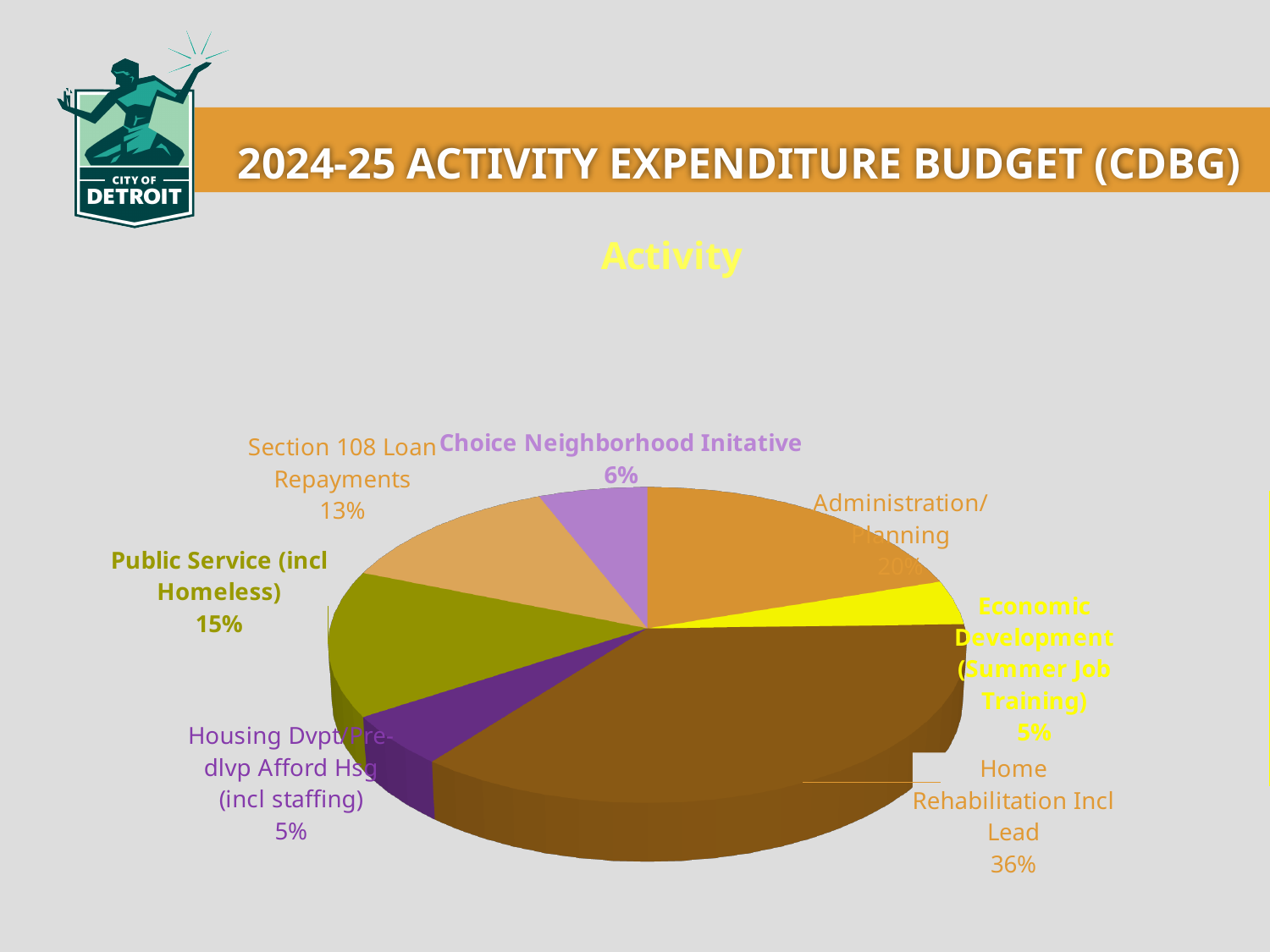
How many slices does the pie chart have? 7 What share of the budget goes to Choice Neighborhood Initiative? 6% What kind of chart is shown on the slide? pie chart Which activity has the largest share of the budget? Home Rehabilitation Incl Lead What is the difference in percentage points between Section 108 Loan Repayments and Choice Neighborhood Initiative? 7 Which is larger, the share for Public Service (incl Homeless) or the share for Section 108 Loan Repayments? Public Service (incl Homeless) What share of the budget goes to Economic Development (Summer Job Training)? 5% What share of the budget goes to Home Rehabilitation Incl Lead? 36% What share of the budget goes to Public Service (incl Homeless)? 15% What is the difference in percentage points between Home Rehabilitation Incl Lead and Public Service (incl Homeless)? 21 What share of the budget goes to Section 108 Loan Repayments? 13% What is the title of the chart? Activity